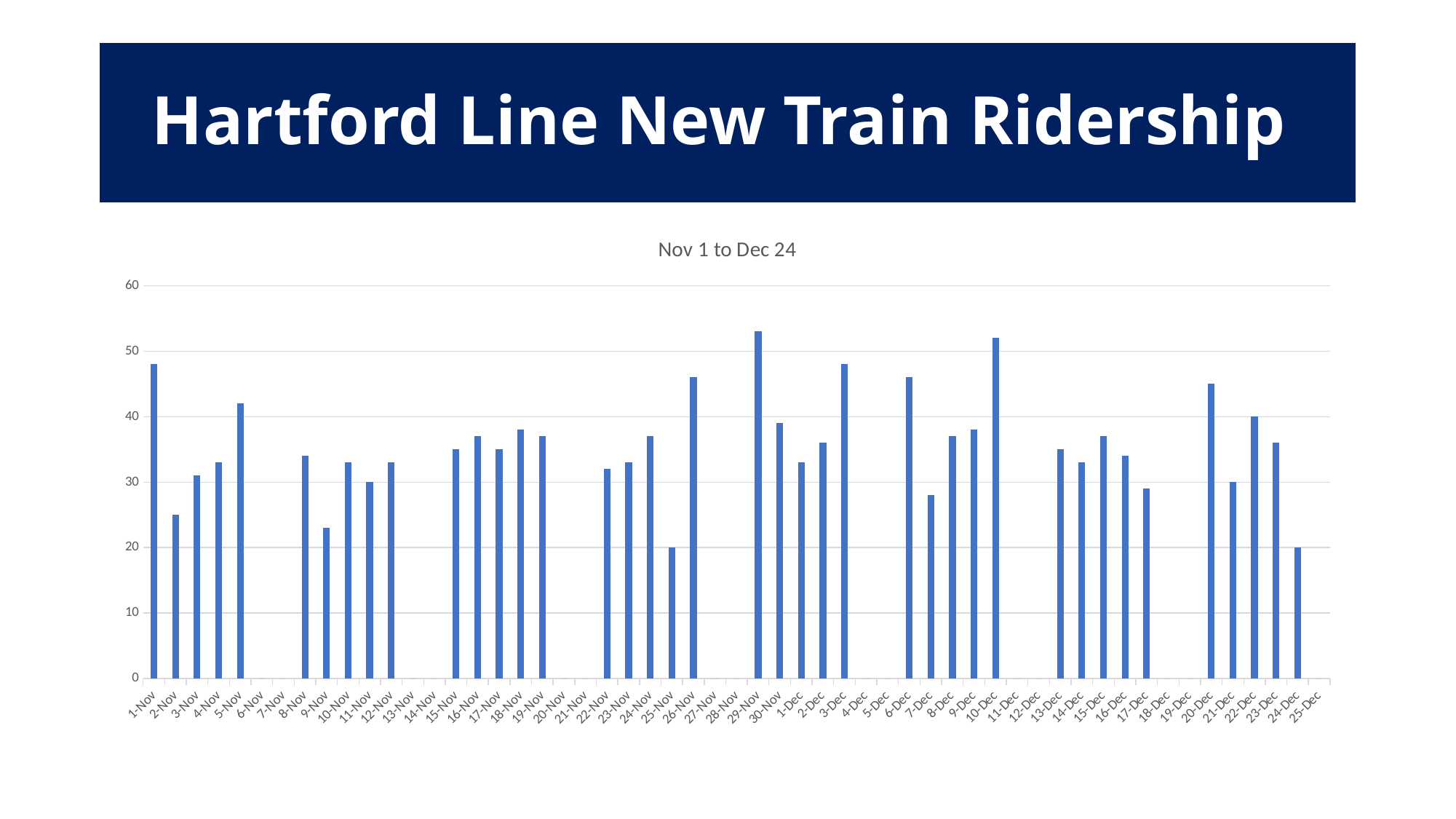
Is the value for 5-Nov greater or less than 40? greater Is the value for 7-Dec greater or less than 30? less What kind of chart is shown on the slide? bar chart Is the value for 9-Nov greater or less than 30? less What is the value for 11-Nov? 30 What is the value for 22-Dec? 40 Which is larger, the value for 1-Nov or the value for 2-Nov? 1-Nov What is the title shown above the chart? Nov 1 to Dec 24 Which is larger, the value for 29-Nov or the value for 30-Nov? 29-Nov What is the value for 25-Nov? 20